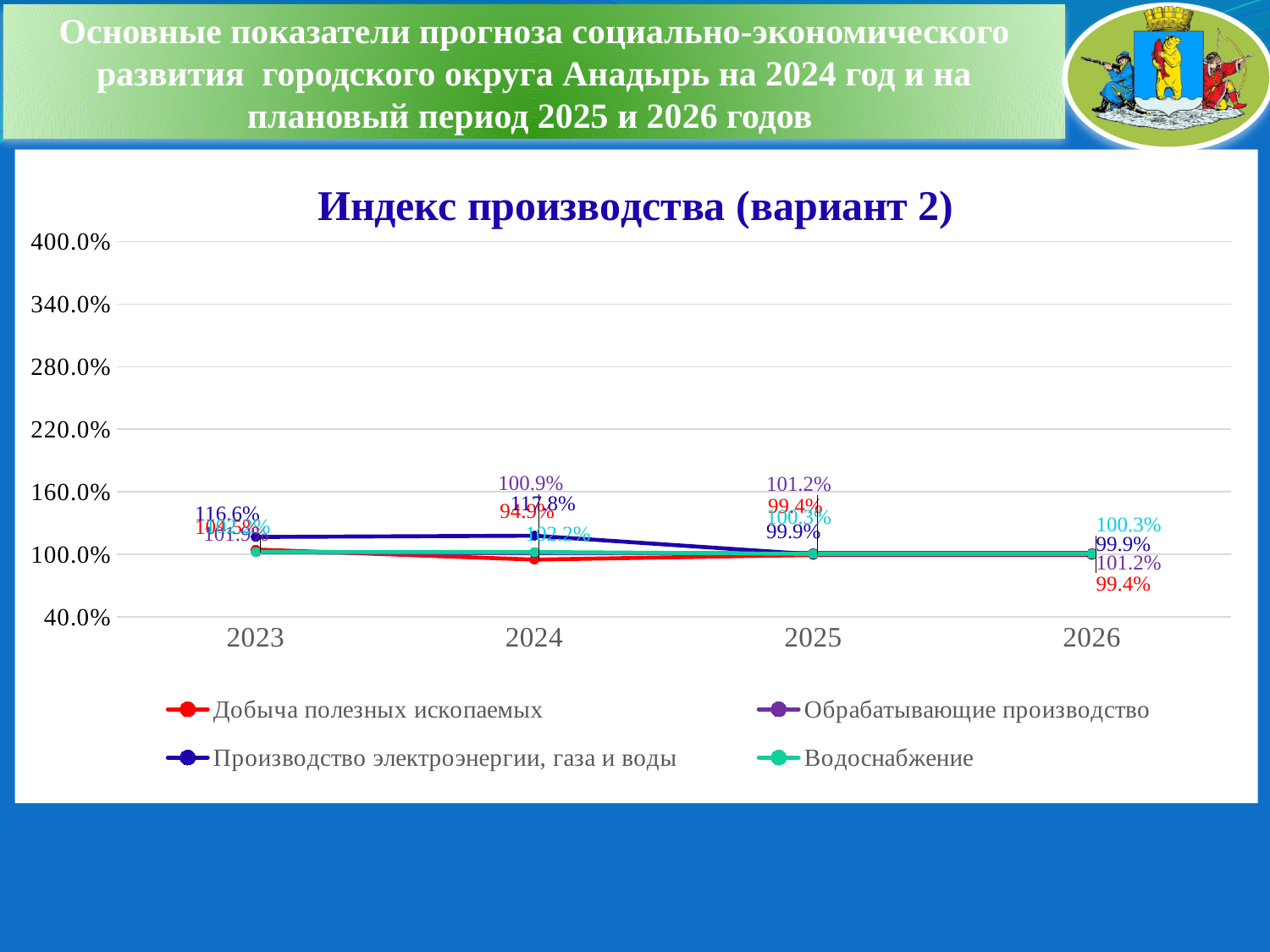
What is the value for Водоснабжение in 2026? 100.3% In 2025, which is larger: Обрабатывающие производство or Добыча полезных ископаемых? Обрабатывающие производство What is the value for Производство электроэнергии, газа и воды in 2023? 116.6% What kind of chart is shown on the slide? line chart What is the difference between Производство электроэнергии, газа и воды and Добыча полезных ископаемых in 2024? 22.9 percentage points What is the value for Производство электроэнергии, газа и воды in 2024? 117.8% What is the value for Добыча полезных ископаемых in 2024? 94.9% What is the value for Обрабатывающие производство in 2025? 101.2% Which series has the lowest value in 2024? Добыча полезных ископаемых What is the title of the chart? Индекс производства (вариант 2) How many years are shown on the x axis? 4 How many series does the legend list? 4